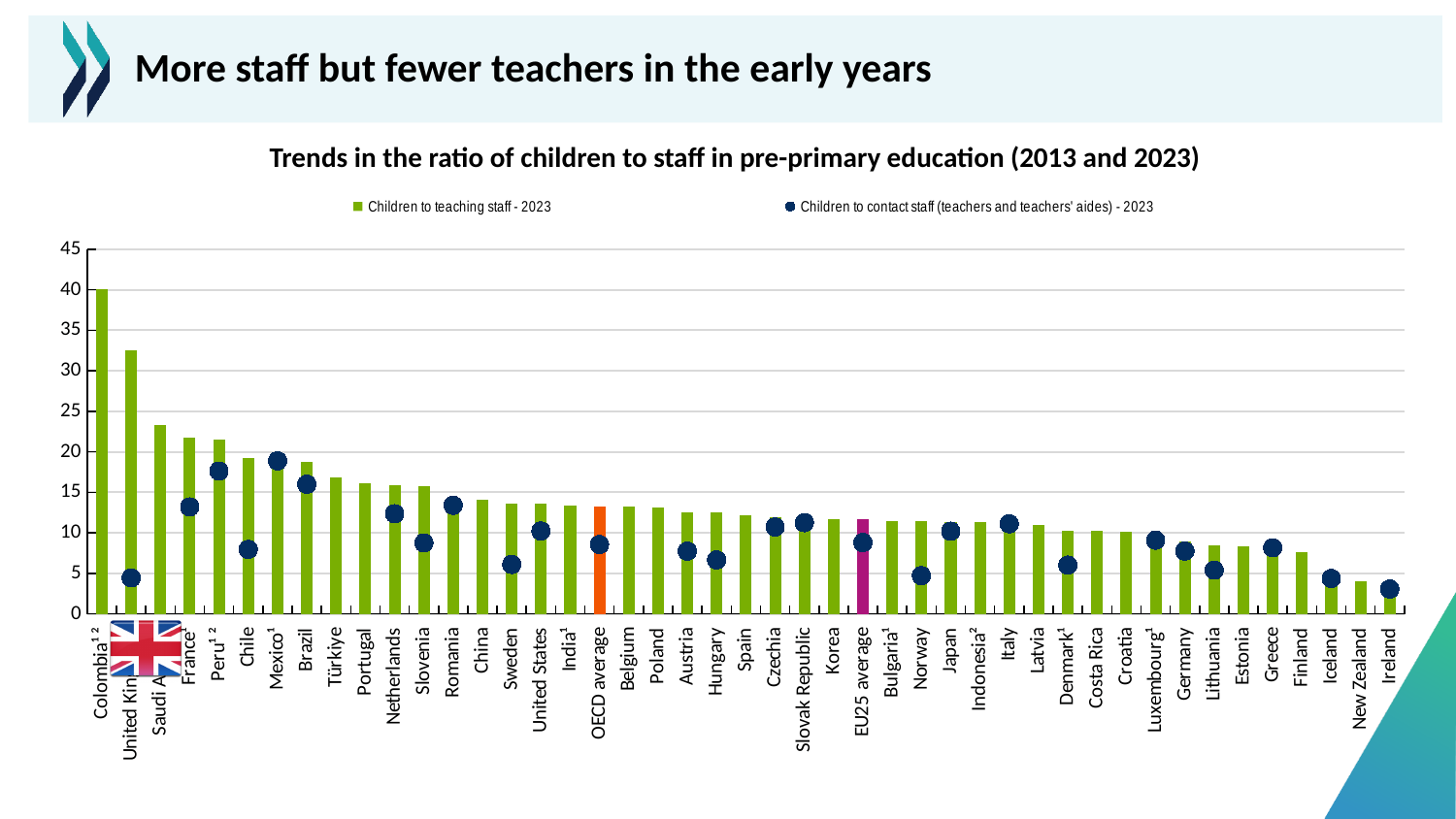
Which country has the highest children to teaching staff ratio (tallest bar)? Colombia Which country has the lowest children to teaching staff ratio (shortest bar)? Ireland What is the title of the chart? Trends in the ratio of children to staff in pre-primary education (2013 and 2023) What kind of chart is this? Combination chart (bars with dot markers) Is the children to contact staff value for Norway greater or less than 10? less Which country has the highest children to contact staff ratio (highest dot)? Mexico Do the children to teaching staff bars rise or fall from left to right across the chart? fall Is the children to teaching staff value for Colombia greater or less than 35? greater Which bar is shown in orange rather than green? OECD average Is the children to contact staff value for the United Kingdom greater or less than 10? less How many series does the legend list? 2